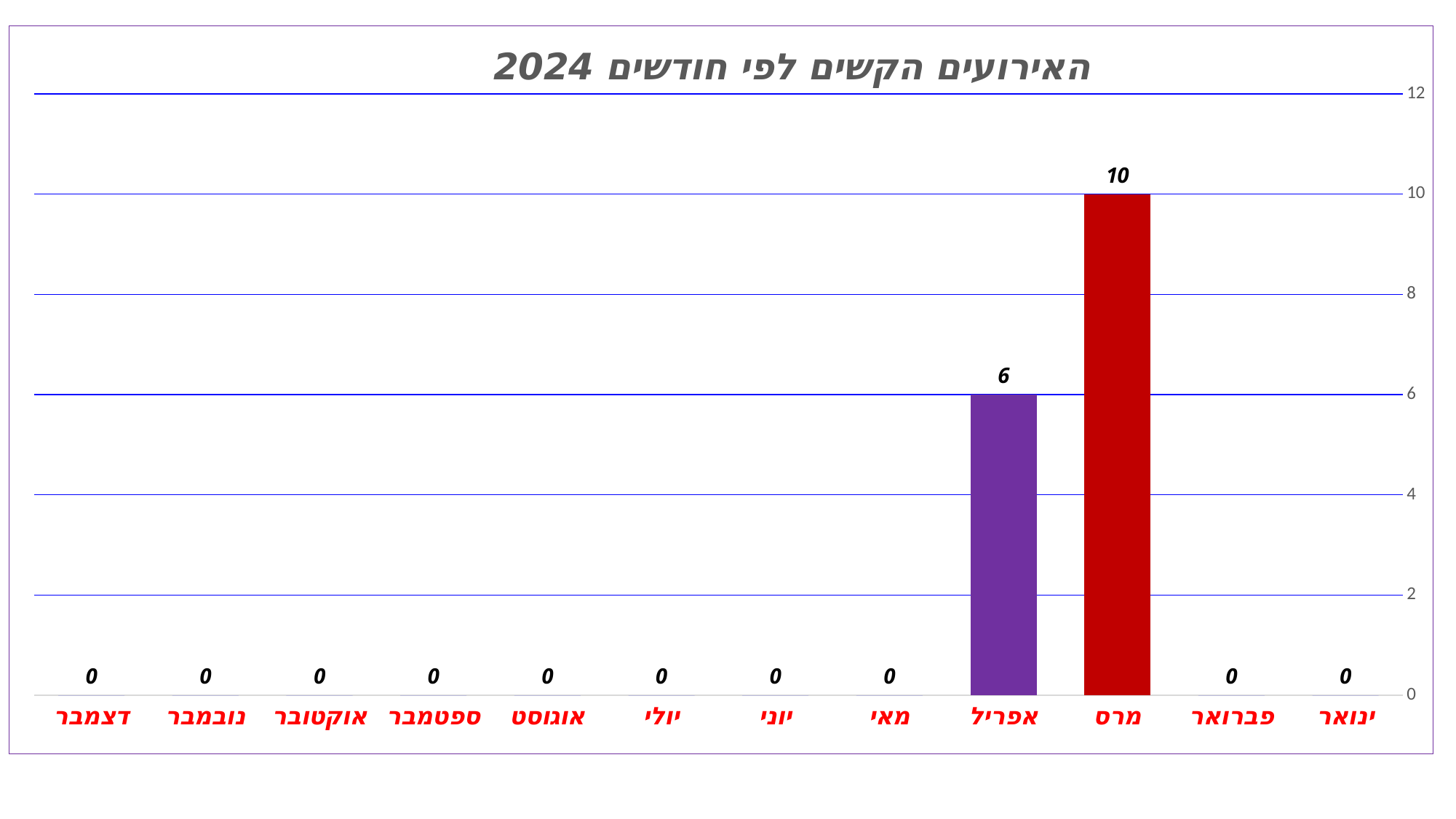
How many months have a value of 0 in the chart? 10 What kind of chart is shown on the slide? Bar chart What colour is the bar for מרס (March)? Red What is the title of the chart? האירועים הקשים לפי חודשים 2024 What is the value for ינואר (January) in the chart? 0 What is the value for מרס (March) in the chart? 10 Is the value for מרס (March) greater or less than 8? greater How many months (categories) are shown on the x axis of the chart? 12 What is the value for אפריל (April) in the chart? 6 Which month has the highest value in the chart? מרס (March) What is the difference between the values for מרס (March) and אפריל (April)? 4 Which is larger, the value for מרס (March) or the value for אפריל (April)? מרס (March)